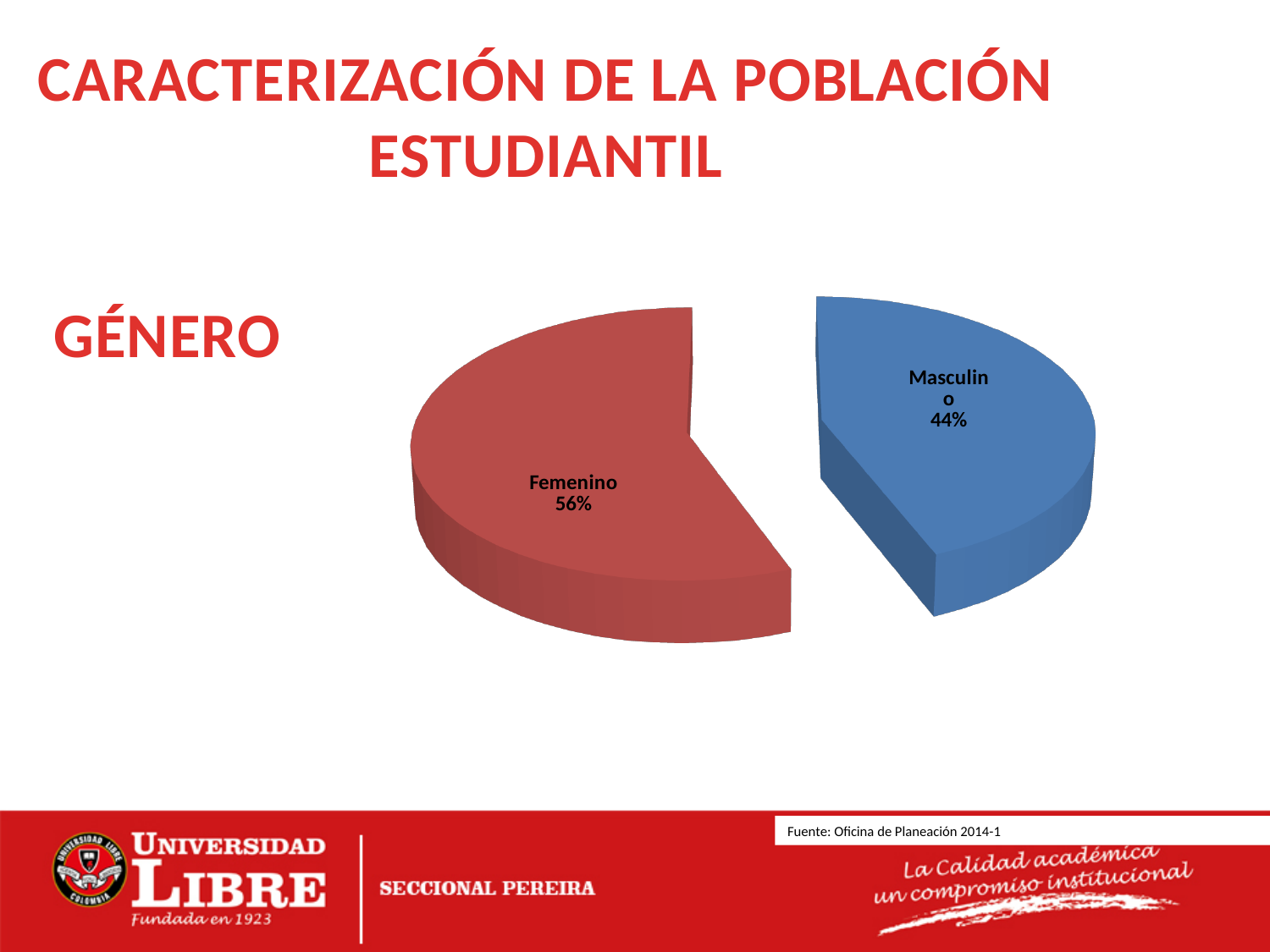
What share of the pie does Masculino represent? 44% Which category has the largest slice of the pie? Femenino Is the share for Masculino greater or less than 50%? less What colour is the Femenino slice? Red Which category has the smallest slice of the pie? Masculino How many slices does the pie chart have? 2 What share of the pie does Femenino represent? 56% What kind of chart is shown on the slide? Pie chart What label appears to the left of the pie chart describing what it shows? GÉNERO Which is larger, the Femenino slice or the Masculino slice? Femenino What is the difference in percentage points between the Femenino and Masculino slices? 12 percentage points